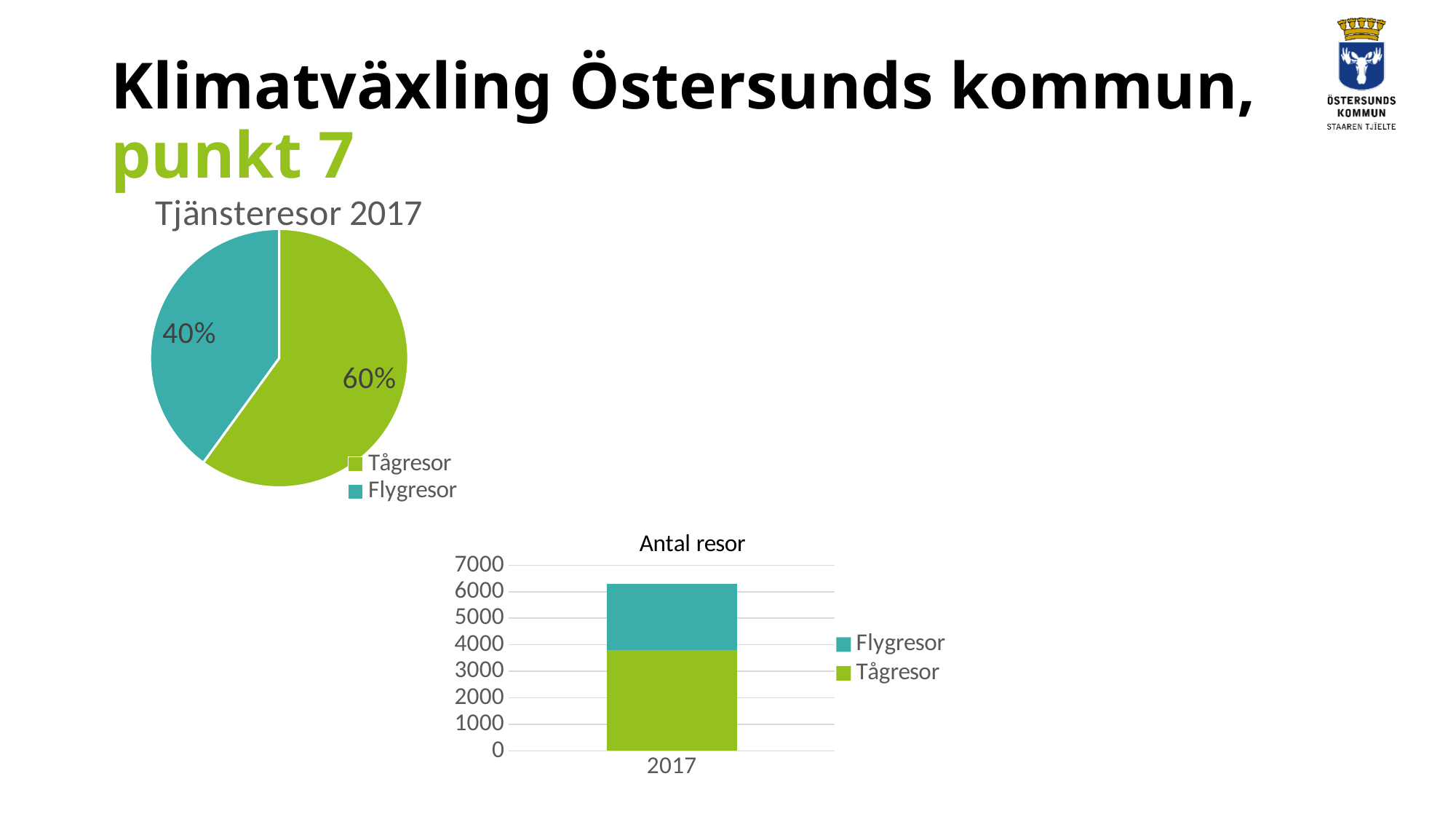
In the pie chart titled Tjänsteresor 2017, what is the difference in percentage points between Tågresor and Flygresor? 20 percentage points In the chart titled Antal resor, is the total height of the stacked bar for 2017 greater or less than 6000? greater In the chart titled Antal resor, is the Tågresor segment for 2017 greater or less than 3000? greater In the pie chart titled Tjänsteresor 2017, which category has the smaller share? Flygresor In the pie chart titled Tjänsteresor 2017, what share is Tågresor? 60% What kind of chart is the chart titled Antal resor? Bar chart In the chart titled Antal resor, which category is shown on the x axis? 2017 In the chart titled Antal resor, how many series does the legend list? 2 What kind of chart is the chart titled Tjänsteresor 2017? Pie chart In the pie chart titled Tjänsteresor 2017, what share is Flygresor? 40% In the pie chart titled Tjänsteresor 2017, which category has the larger share? Tågresor In the pie chart titled Tjänsteresor 2017, how many slices are there? 2